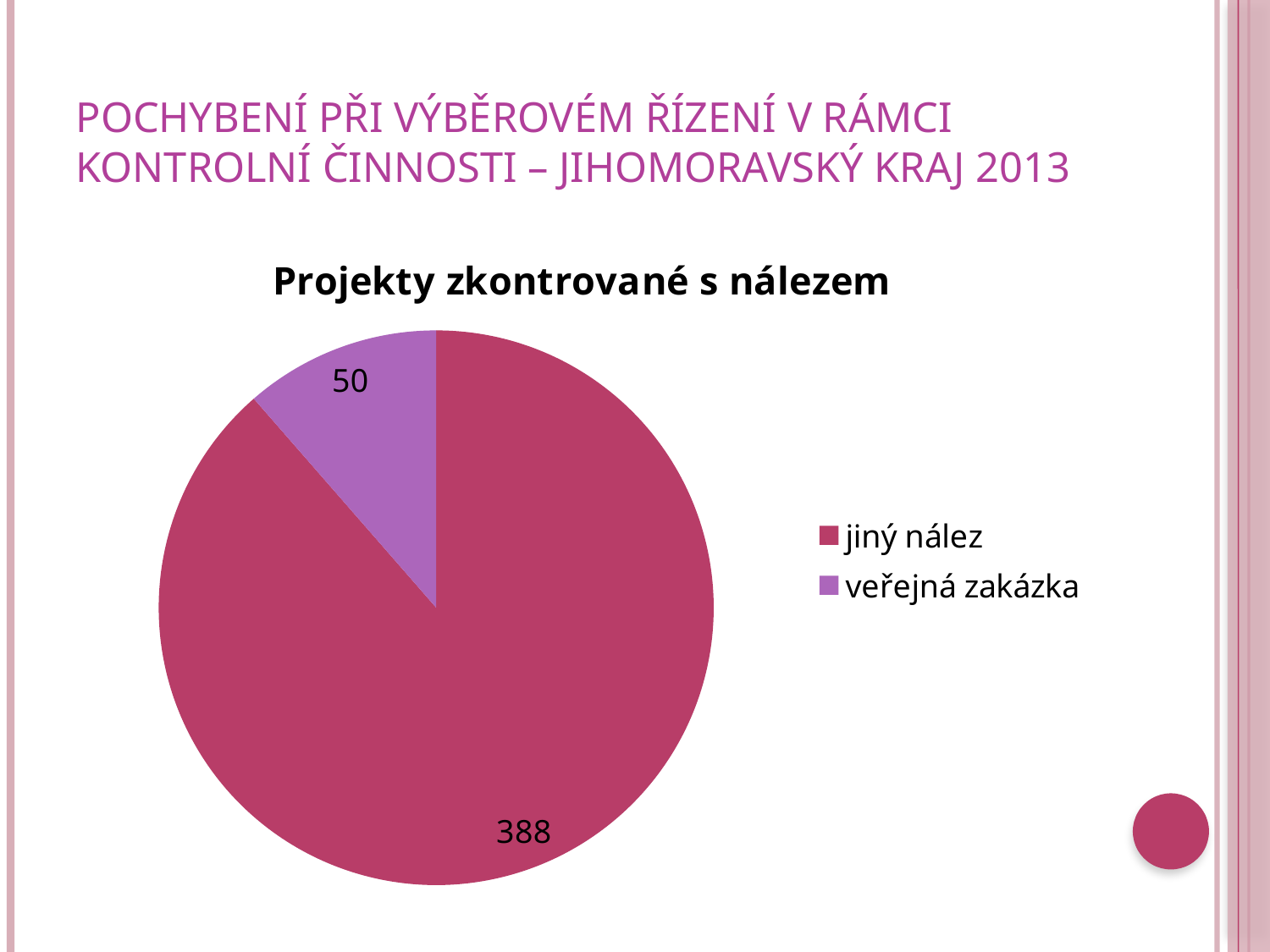
How many slices does the pie chart have? 2 Which is larger, the value for jiný nález or the value for veřejná zakázka? jiný nález What is the difference between the values for jiný nález and veřejná zakázka? 338 What is the value for veřejná zakázka in the pie chart? 50 Which category has the smallest slice in the pie chart? veřejná zakázka Which category has the largest slice in the pie chart? jiný nález Which legend entry is shown in purple? veřejná zakázka What is the value for jiný nález in the pie chart? 388 What is the title of the chart? Projekty zkontrované s nálezem What kind of chart is shown on the slide? pie chart What is the total of the two values shown in the pie chart? 438 How many entries does the legend list? 2